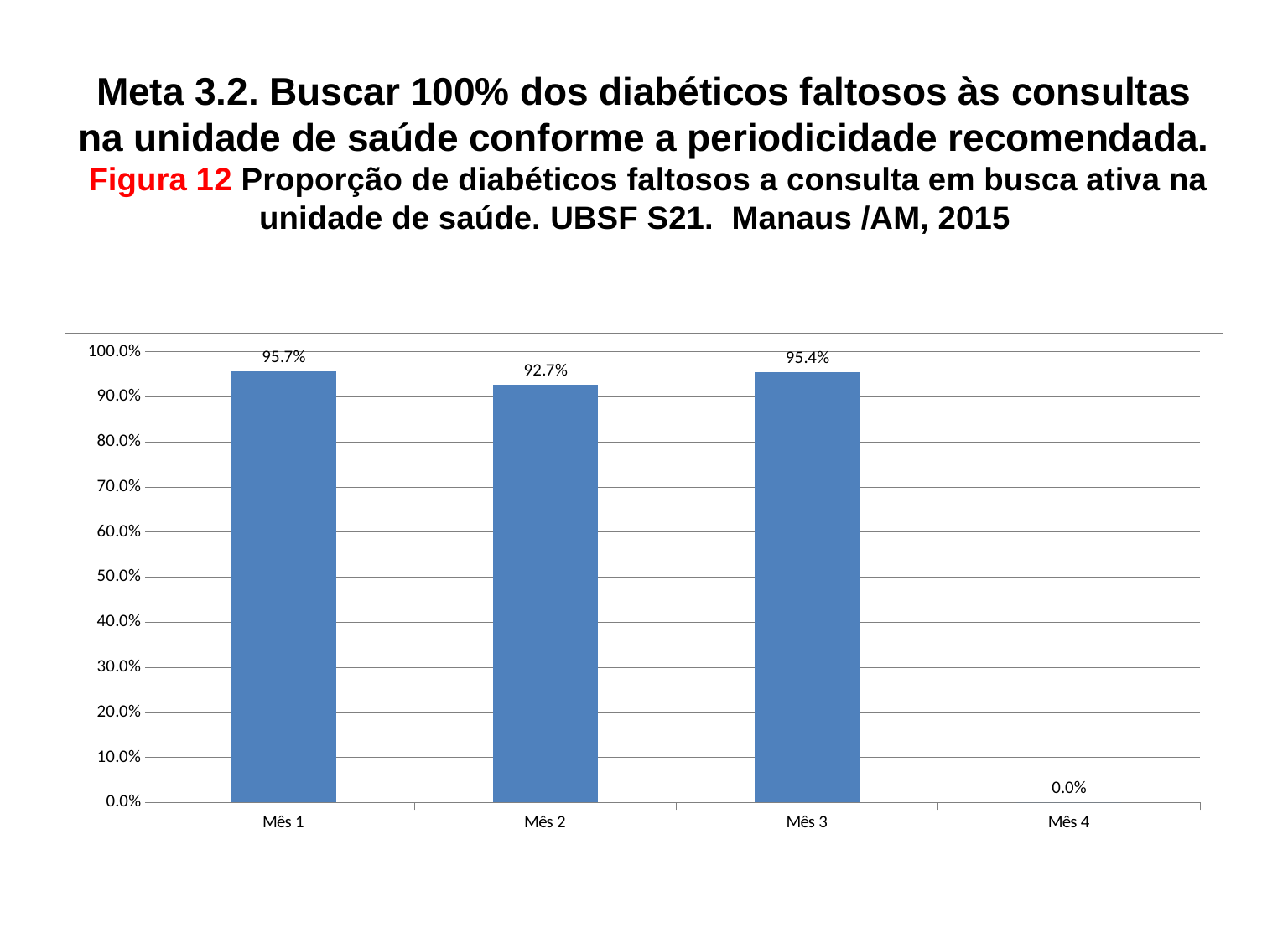
Is the value for Mês 2 greater or less than 90.0%? greater What is the value for Mês 4? 0.0% How many months are shown on the x axis? 4 Which month has the lowest value? Mês 4 What is the value for Mês 2? 92.7% Which is larger, the value for Mês 2 or the value for Mês 3? Mês 3 What is the value for Mês 1? 95.7% What is the value for Mês 3? 95.4% What kind of chart is shown on the slide? bar chart Which month has the highest value? Mês 1 What is the difference between the values for Mês 1 and Mês 2? 3.0% What figure number is given in the slide title? Figura 12